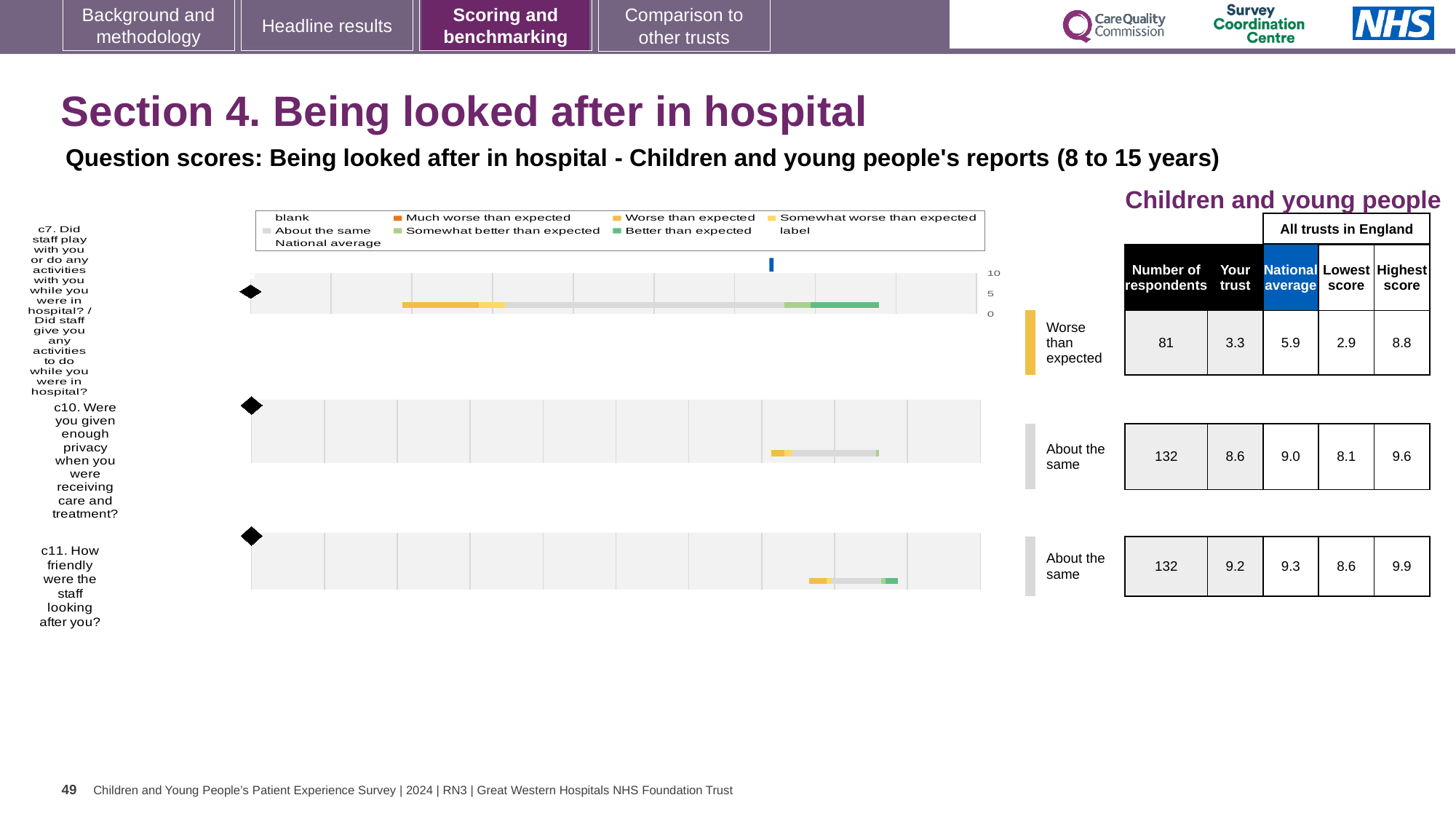
What is the highest score across all trusts in England for question c11 (How friendly were the staff looking after you?)? 9.9 Which question has the lowest 'Your trust' score on this slide? c7 Which has the larger 'Your trust' score, question c10 or question c11? c11 How many respondents answered question c10 (Were you given enough privacy when you were receiving care and treatment?)? 132 How many questions are charted on this slide? 3 What is the lowest score across all trusts in England for question c10? 8.1 What benchmark category is shown for question c7? Worse than expected What is the difference between the national average and the 'Your trust' score for question c7? 2.6 What is the national average score for question c7? 5.9 Which question has the highest 'Your trust' score on this slide? c11 What kind of chart is used to show the question scores on this slide? Bar chart What is the 'Your trust' score for question c7 (Did staff play with you or do any activities with you while you were in hospital?)? 3.3